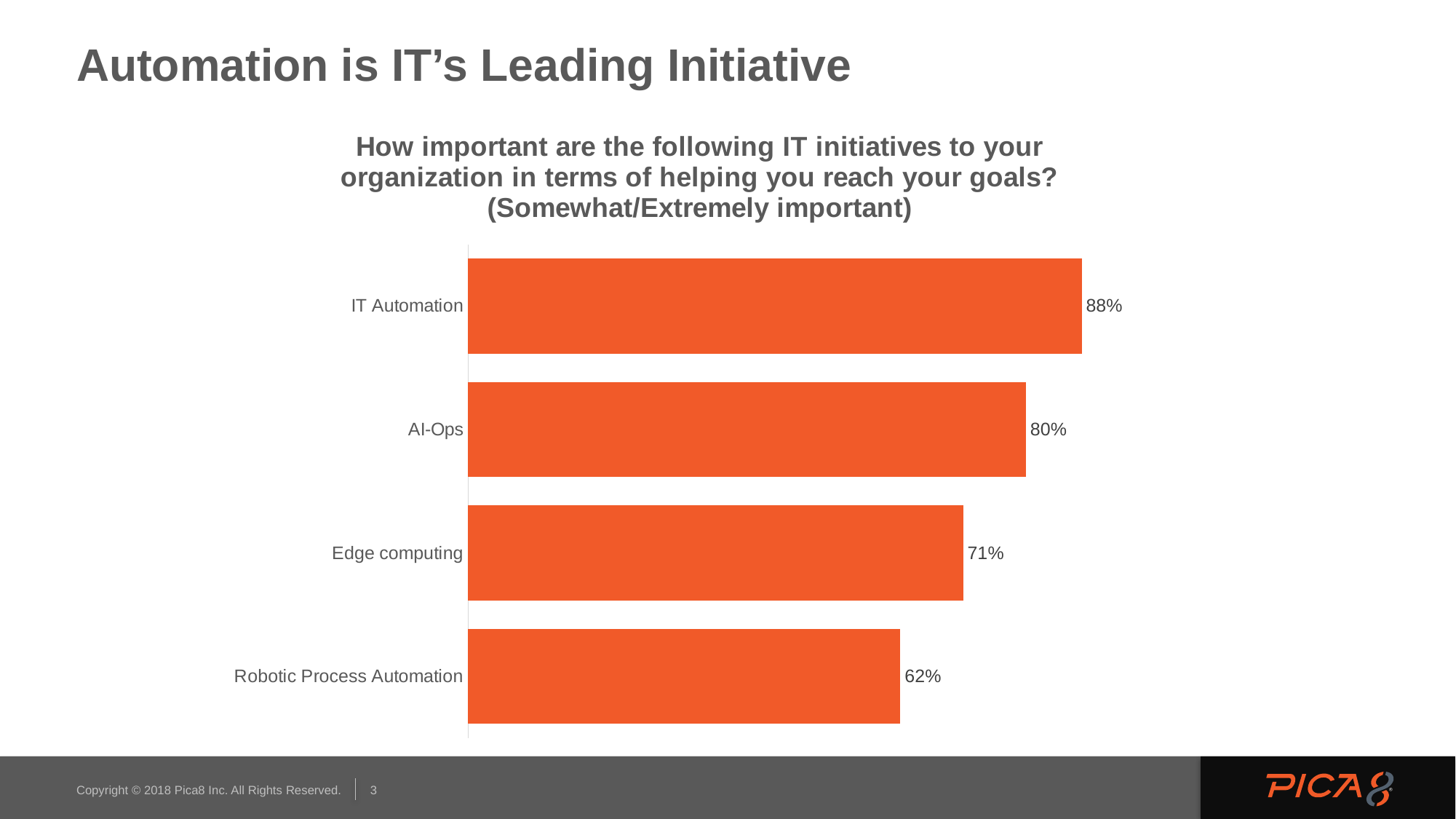
What is the value shown for Edge computing? 71% Which IT initiative has the lowest value in the chart? Robotic Process Automation What is the value shown for AI-Ops? 80% What colour are the bars in the chart? Orange What is the difference between the values for AI-Ops and Edge computing? 9% Which has a larger value, AI-Ops or Edge computing? AI-Ops Which IT initiative has the highest value in the chart? IT Automation What kind of chart is shown on the slide? Bar chart What is the value shown for Robotic Process Automation? 62% How many IT initiatives are shown in the chart? 4 What percentage of respondents rated IT Automation as somewhat or extremely important? 88% What is the difference between the values for IT Automation and Robotic Process Automation? 26%